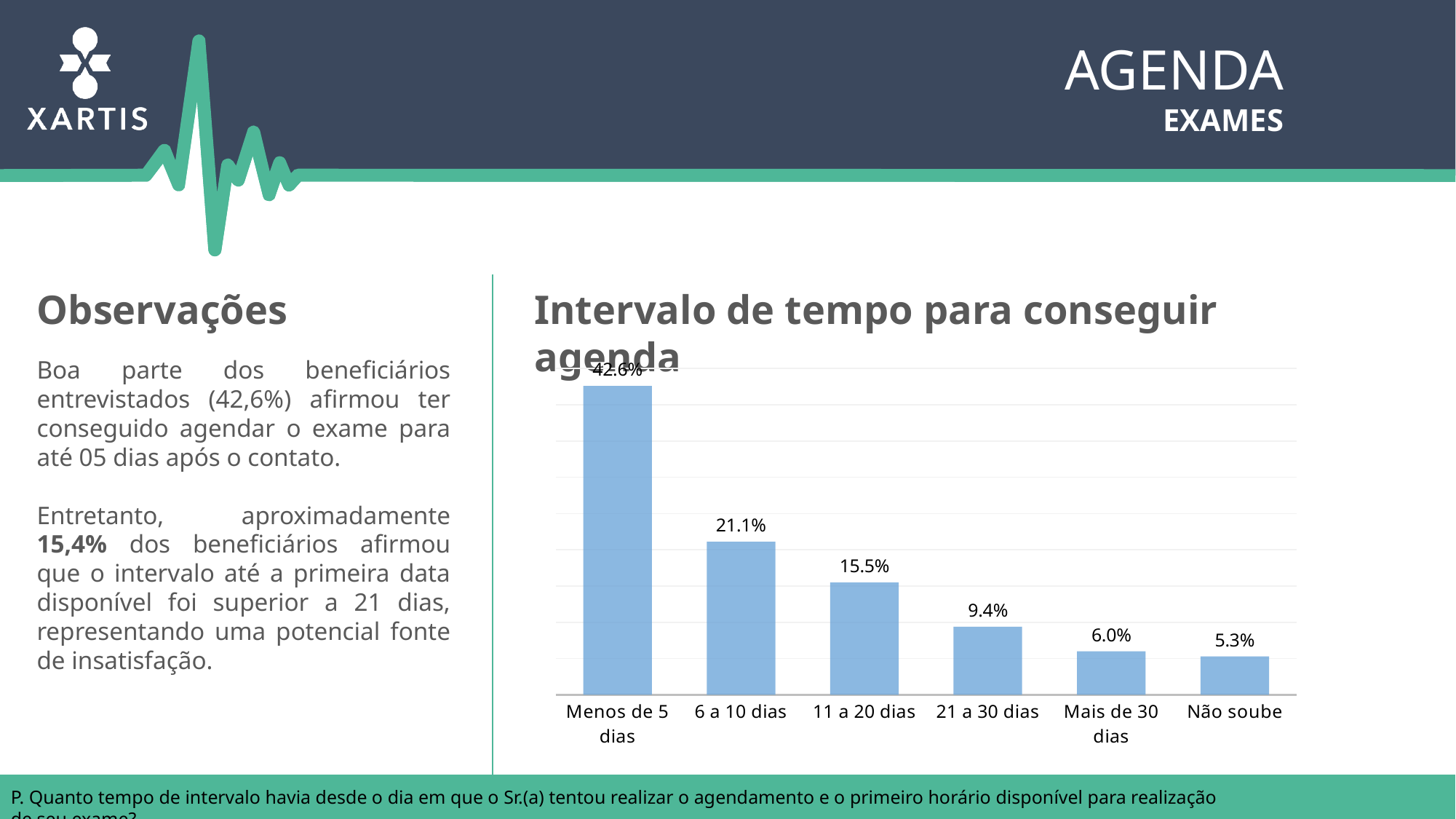
What is the difference between the values for "Menos de 5 dias" and "6 a 10 dias"? 21.5% What is the value for "Menos de 5 dias"? 42.6% What kind of chart is shown? Bar chart Which category has the lowest value? Não soube What is the value for "Não soube"? 5.3% What is the value for "6 a 10 dias"? 21.1% What is the difference between the values for "11 a 20 dias" and "21 a 30 dias"? 6.1% What is the value for "Mais de 30 dias"? 6.0% Which is larger, the value for "21 a 30 dias" or the value for "Mais de 30 dias"? 21 a 30 dias Which category has the highest value? Menos de 5 dias How many categories are shown on the x axis? 6 Do the values rise or fall from left to right along the x axis? Fall